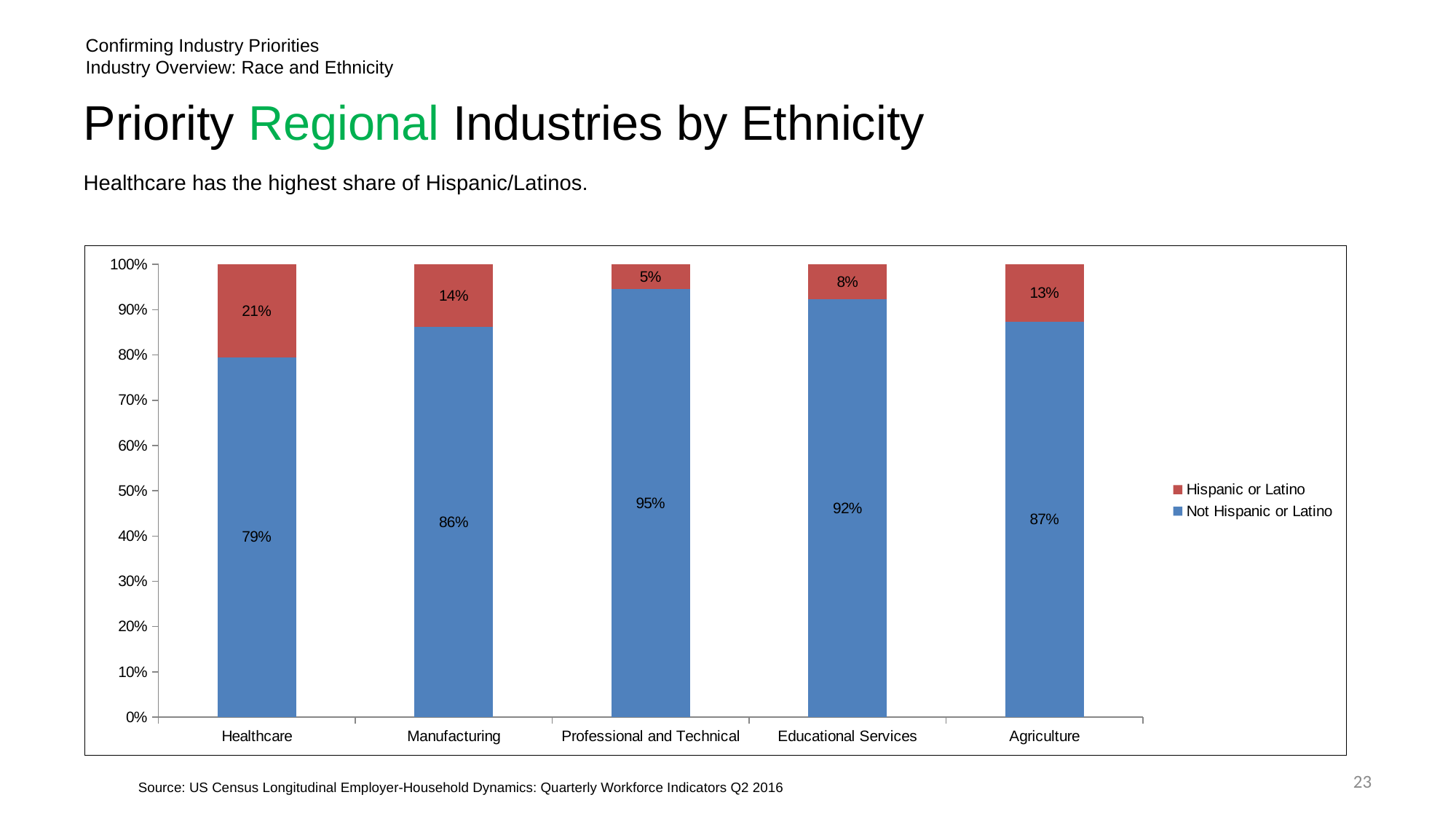
What is the total of the stacked bar for Educational Services? 100% What is the Hispanic or Latino share for Healthcare? 21% What kind of chart is shown on the slide? Stacked bar chart Which colour represents Hispanic or Latino in the legend? Red How many industries are shown on the x axis? 5 Which industry has the lowest Hispanic or Latino share? Professional and Technical What is the difference between the Hispanic or Latino share for Manufacturing and for Educational Services? 6% Which industry has the highest Hispanic or Latino share? Healthcare Which has a larger Not Hispanic or Latino share, Manufacturing or Agriculture? Agriculture How many series does the legend list? 2 What is the Not Hispanic or Latino share for Professional and Technical? 95% What is the Hispanic or Latino share for Agriculture? 13%